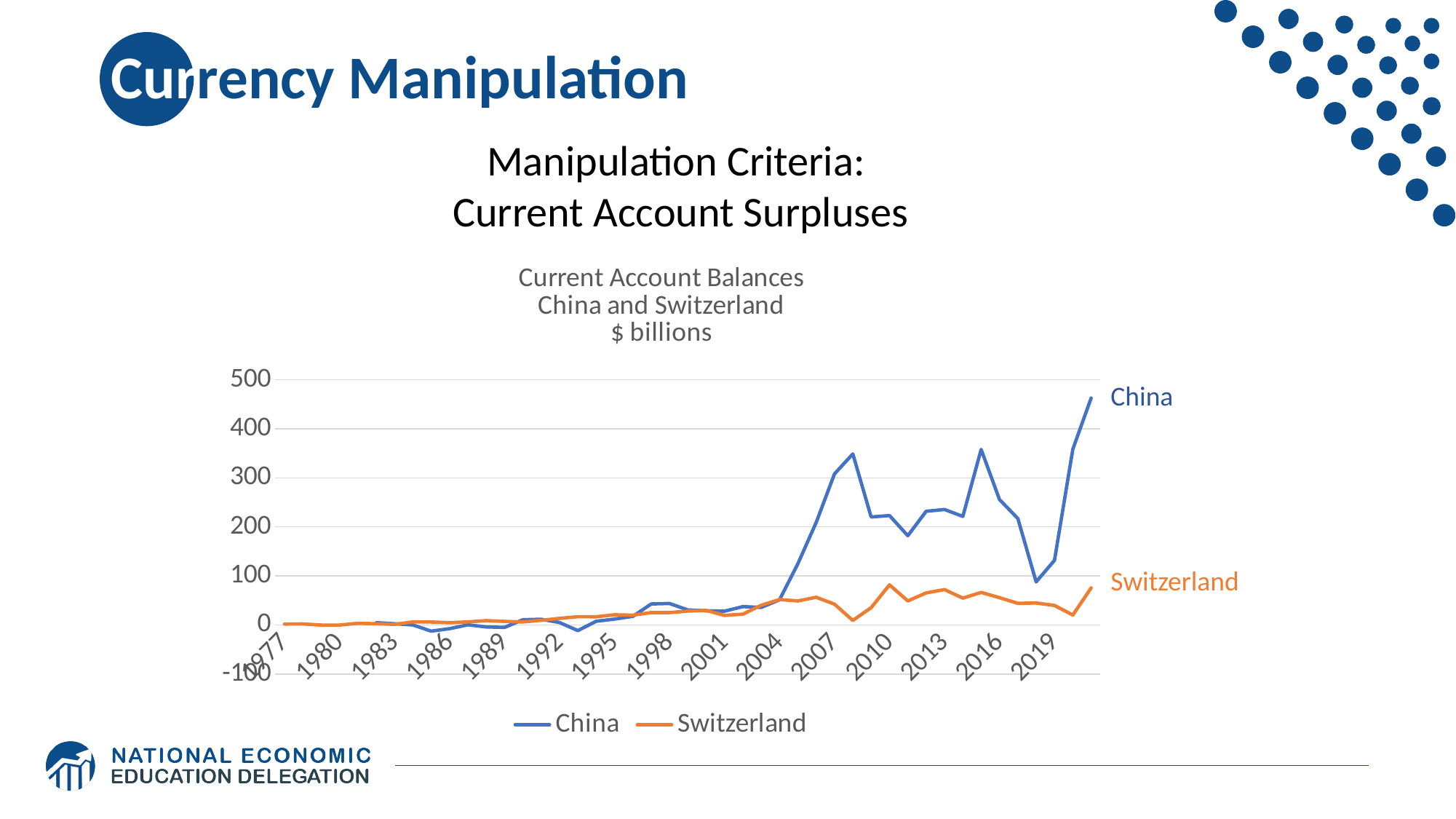
Is the value for Switzerland in 2010 greater or less than 200? less How many series does the legend list? 2 What unit is given in the chart title? $ billions What kind of chart is shown on the slide? line chart Does the China line overall rise or fall from 1977 to the end of the series? rise Is the value for China in 2004 greater or less than 100? less Which series reaches the highest value on the chart? China At the right end of the chart, which series has the larger value, China or Switzerland? China How many year labels are shown on the x axis? 15 Is the highest point of the Switzerland line greater or less than 100? less Which two countries are plotted in the chart? China and Switzerland